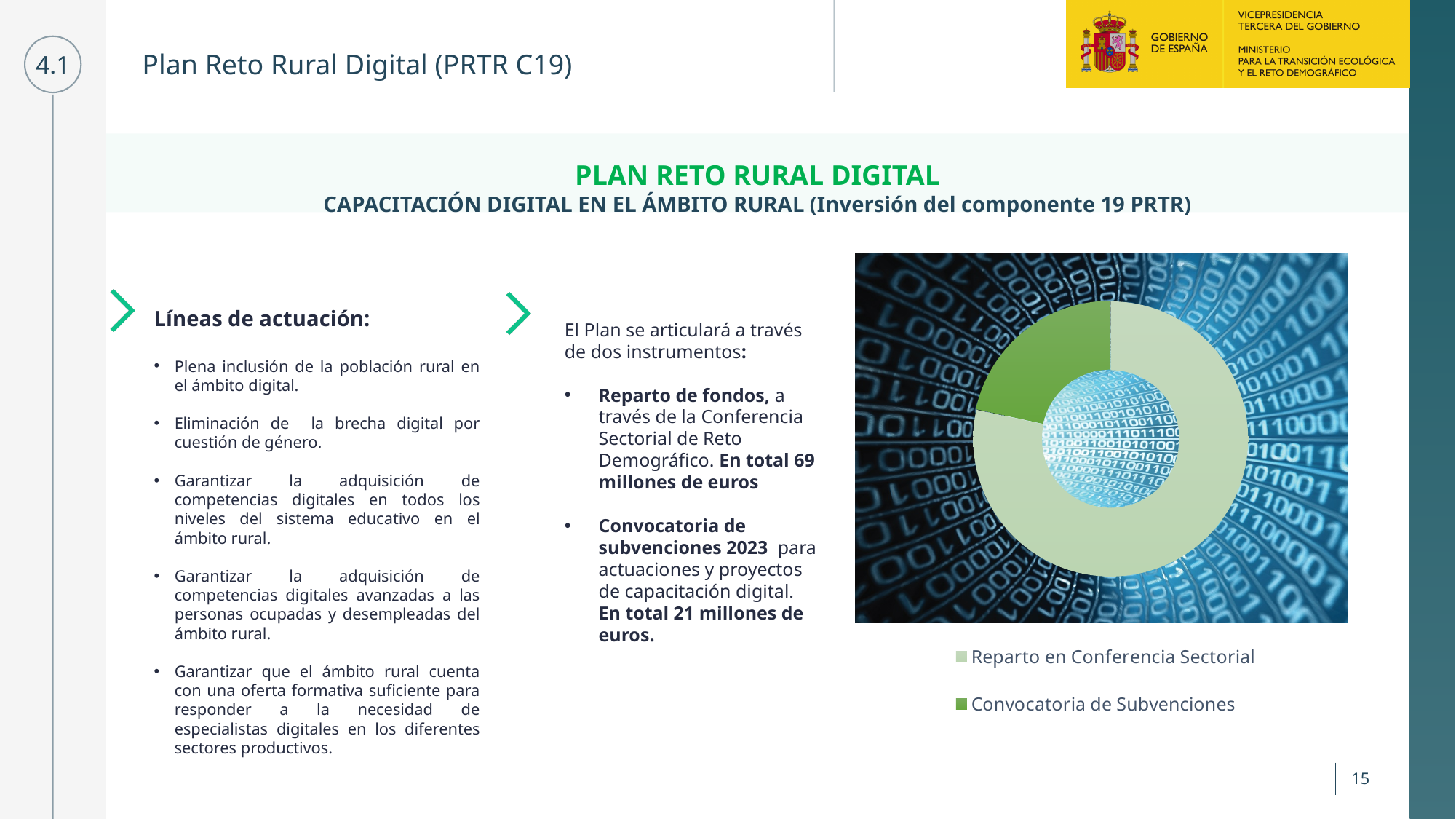
What kind of chart is shown on the slide? doughnut chart Which is larger in the doughnut chart, Reparto en Conferencia Sectorial or Convocatoria de Subvenciones? Reparto en Conferencia Sectorial Which slice of the doughnut chart is the smallest? Convocatoria de Subvenciones Does the Reparto en Conferencia Sectorial slice take up more or less than half of the doughnut chart? more How many entries does the chart legend list? 2 How many slices does the doughnut chart have? 2 What is the first entry listed in the chart legend? Reparto en Conferencia Sectorial What colour represents Convocatoria de Subvenciones in the doughnut chart? dark green Which slice of the doughnut chart is the largest? Reparto en Conferencia Sectorial